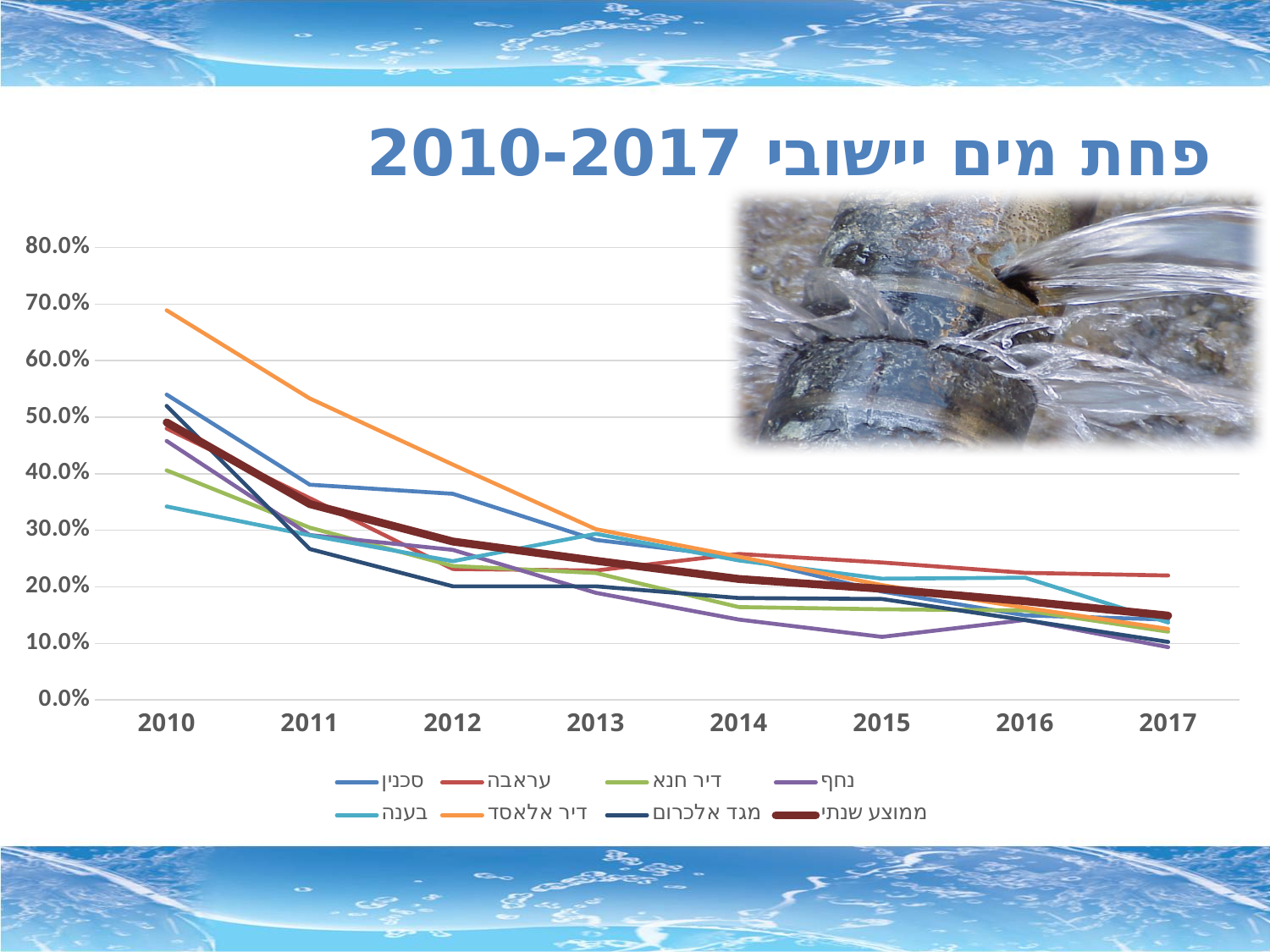
Is the value for בענה in 2010 greater or less than 40.0%? less Which series has the lowest value in 2015? נחף Is the value for ממוצע שנתי in 2017 greater or less than 20.0%? less Which series has the lowest value in 2010? בענה In 2011, which is larger: the value for דיר אלאסד or the value for סכנין? דיר אלאסד How many series does the legend list? 8 Which series has the highest value in 2017? עראבה Does the ממוצע שנתי series rise or fall from 2010 to 2017? fall Which series has the highest value in 2010? דיר אלאסד Is the value for דיר אלאסד in 2010 greater or less than 60.0%? greater What kind of chart is shown on the slide? line chart How many years are shown along the x axis? 8